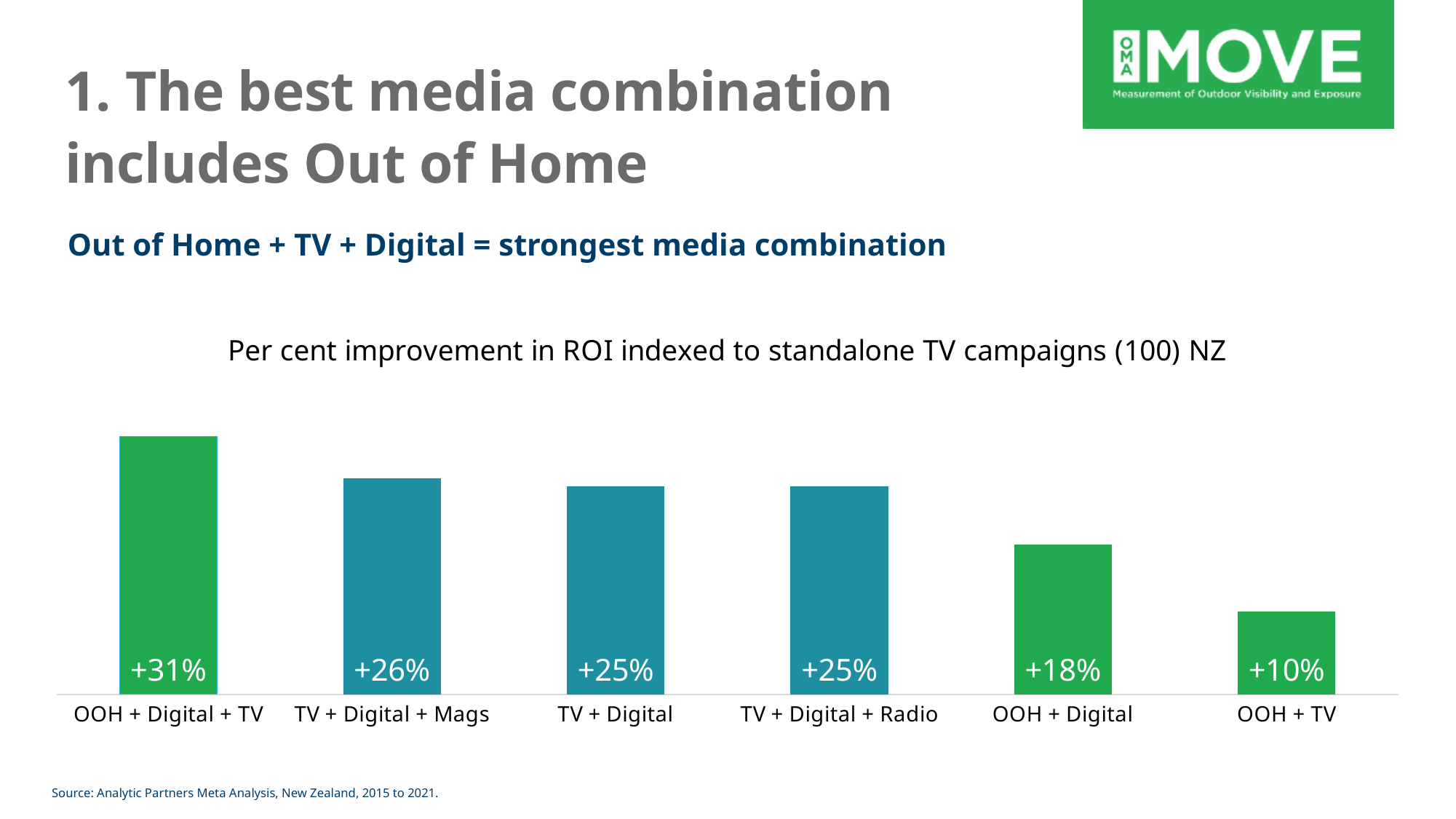
Which is larger, the value for TV + Digital or the value for OOH + Digital? TV + Digital What is the value for OOH + Digital? +18% Which media combination has the lowest per cent improvement in ROI? OOH + TV Which media combination has the highest per cent improvement in ROI? OOH + Digital + TV What kind of chart is shown on the slide? Bar chart How many media combinations are shown in the chart? 6 What is the value for OOH + TV? +10% What is the difference between the values for TV + Digital + Mags and OOH + Digital? 8% What is the difference between the values for OOH + Digital + TV and OOH + TV? 21% What is the value for OOH + Digital + TV? +31% What is the title of the chart? Per cent improvement in ROI indexed to standalone TV campaigns (100) NZ What is the value for TV + Digital + Mags? +26%